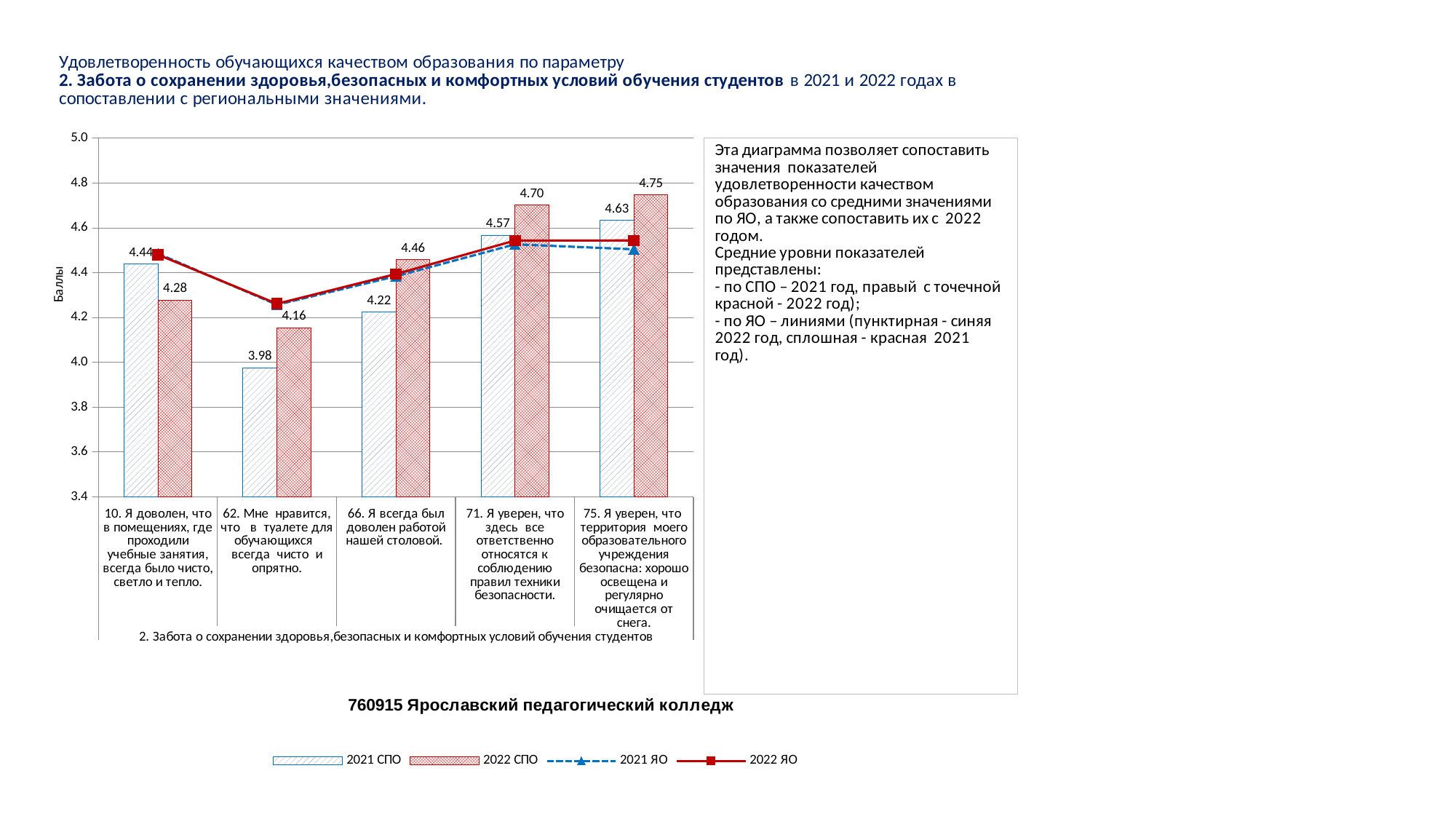
For item 10, which is larger: the 2021 СПО value or the 2022 СПО value? 2021 СПО What is the difference between the 2022 СПО and 2021 СПО values for item 66 (столовая)? 0.24 What is the 2022 СПО value for item 62 (Мне нравится, что в туалете для обучающихся всегда чисто и опрятно)? 4.16 How many items (categories) are shown on the x axis? 5 What is the 2022 СПО value for item 66 (Я всегда был доволен работой нашей столовой)? 4.46 What is the 2021 СПО value for item 71 (Я уверен, что здесь все ответственно относятся к соблюдению правил техники безопасности)? 4.57 What is the label of the vertical axis? Баллы What is the 2021 СПО value for item 10 (Я доволен, что в помещениях, где проходили учебные занятия, всегда было чисто, светло и тепло)? 4.44 Is the 2022 ЯО value for item 62 greater or less than 4.4? less Which item has the highest 2022 СПО value? 75. Я уверен, что территория моего образовательного учреждения безопасна Which item has the lowest 2021 СПО value? 62. Мне нравится, что в туалете для обучающихся всегда чисто и опрятно How many series does the legend list? 4